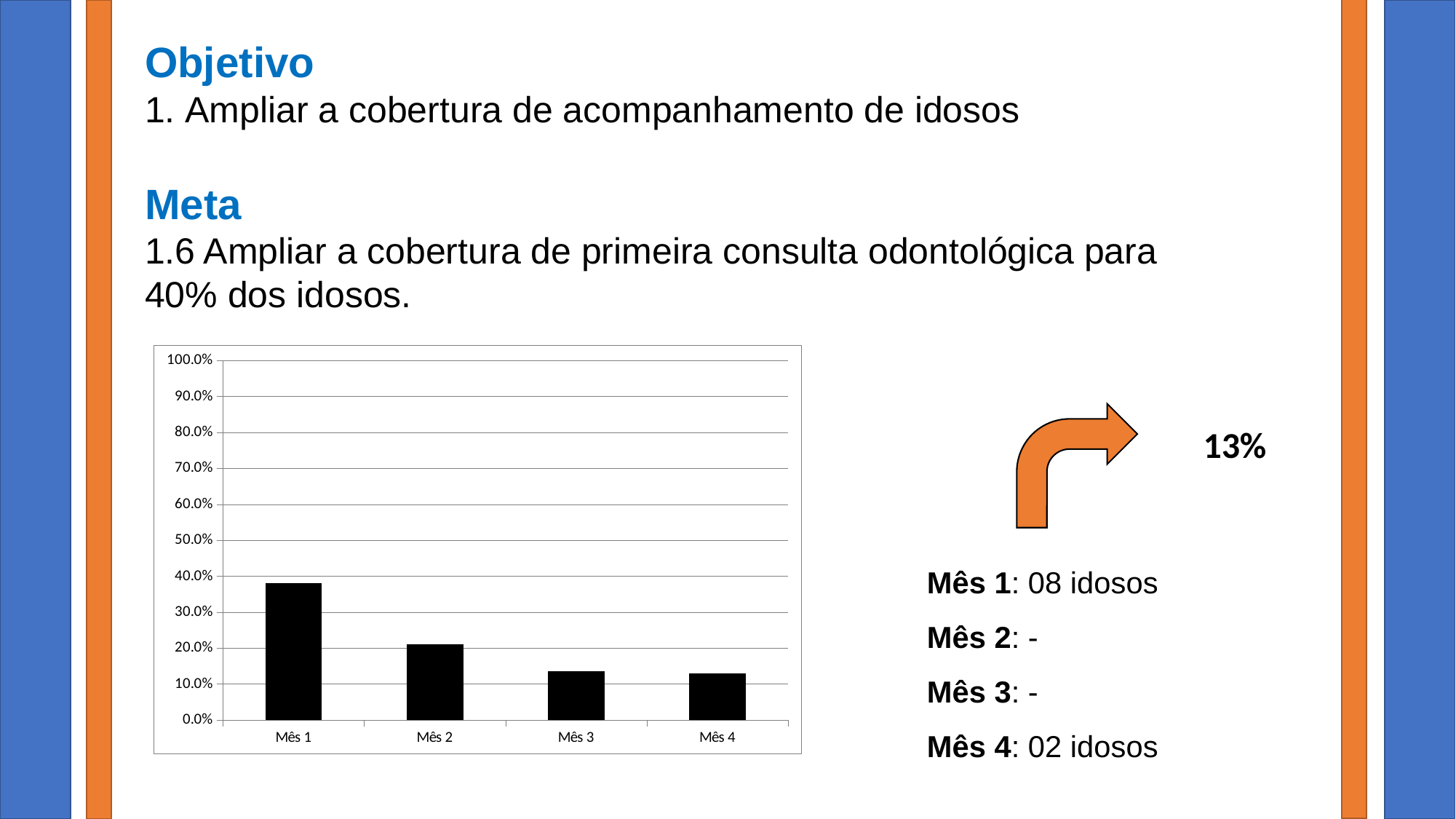
Is the value for Mês 3 greater or less than 10.0%? greater Is the value for Mês 2 greater or less than 30.0%? less Is the value for Mês 1 greater or less than 40.0%? less What kind of chart is shown on the slide? bar chart Do the values rise or fall from Mês 1 to Mês 4? fall Which is larger, the value for Mês 1 or the value for Mês 2? Mês 1 Which is larger, the value for Mês 2 or the value for Mês 4? Mês 2 How many categories are plotted on the x axis of the chart? 4 Which month has the highest value in the chart? Mês 1 What is the highest tick value shown on the chart's y axis? 100.0%